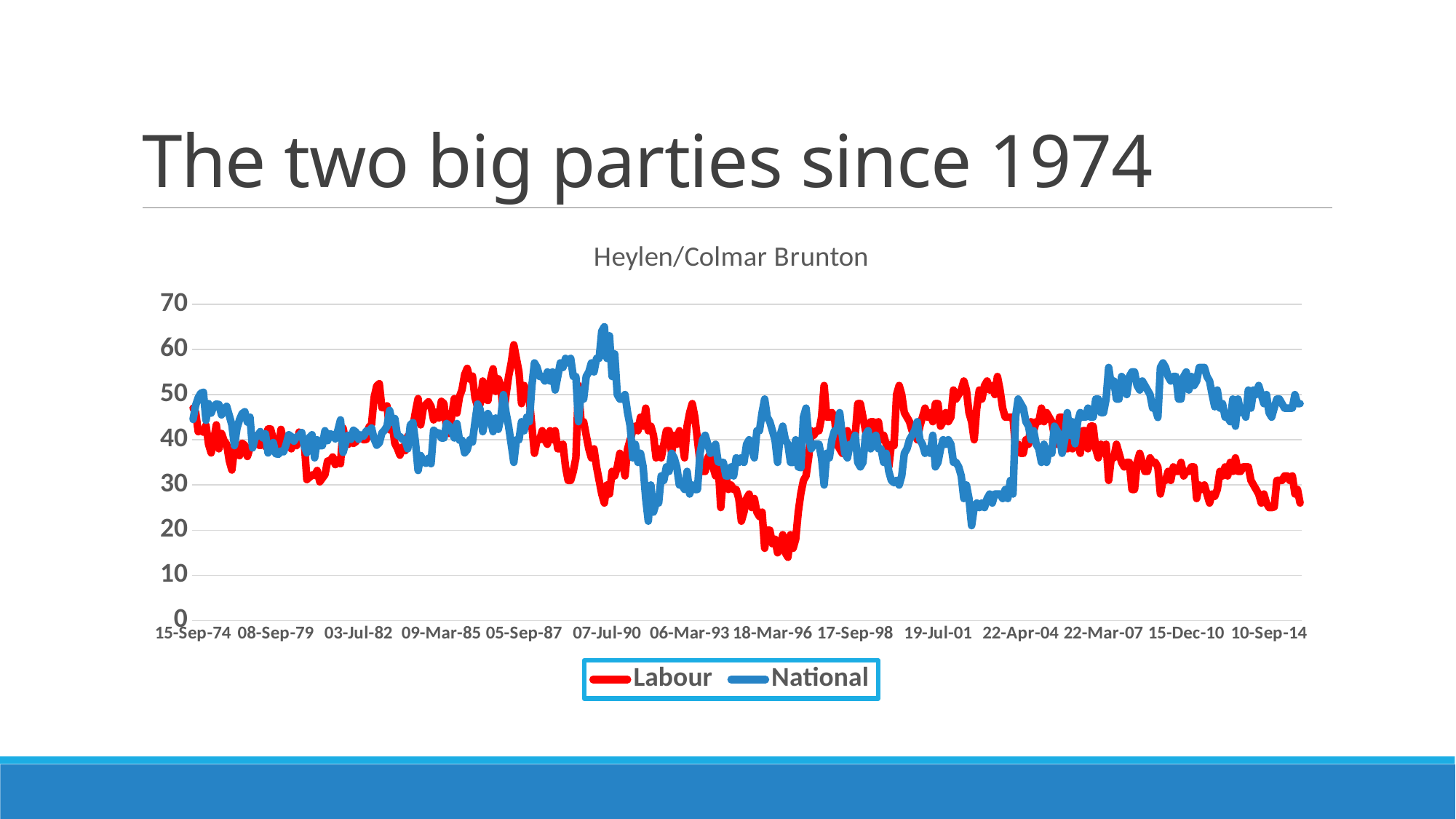
Is the lowest value of the Labour line greater or less than 20? less Which series reaches the highest value anywhere on the chart? National Is the highest value of the National line greater or less than 60? greater Which colour is used for the Labour line? red How many series does the legend list? 2 Does the Labour line generally rise or fall between 22-Mar-07 and 10-Sep-14? fall At the right end of the chart (10-Sep-14), which series has the larger value, Labour or National? National Around 18-Mar-96, which series has the larger value, Labour or National? National Between 19-Jul-01 and 22-Apr-04, which series has the larger value, Labour or National? Labour Which series reaches the lowest value anywhere on the chart? Labour What kind of chart is shown on the slide? line chart What is the title of the chart? Heylen/Colmar Brunton